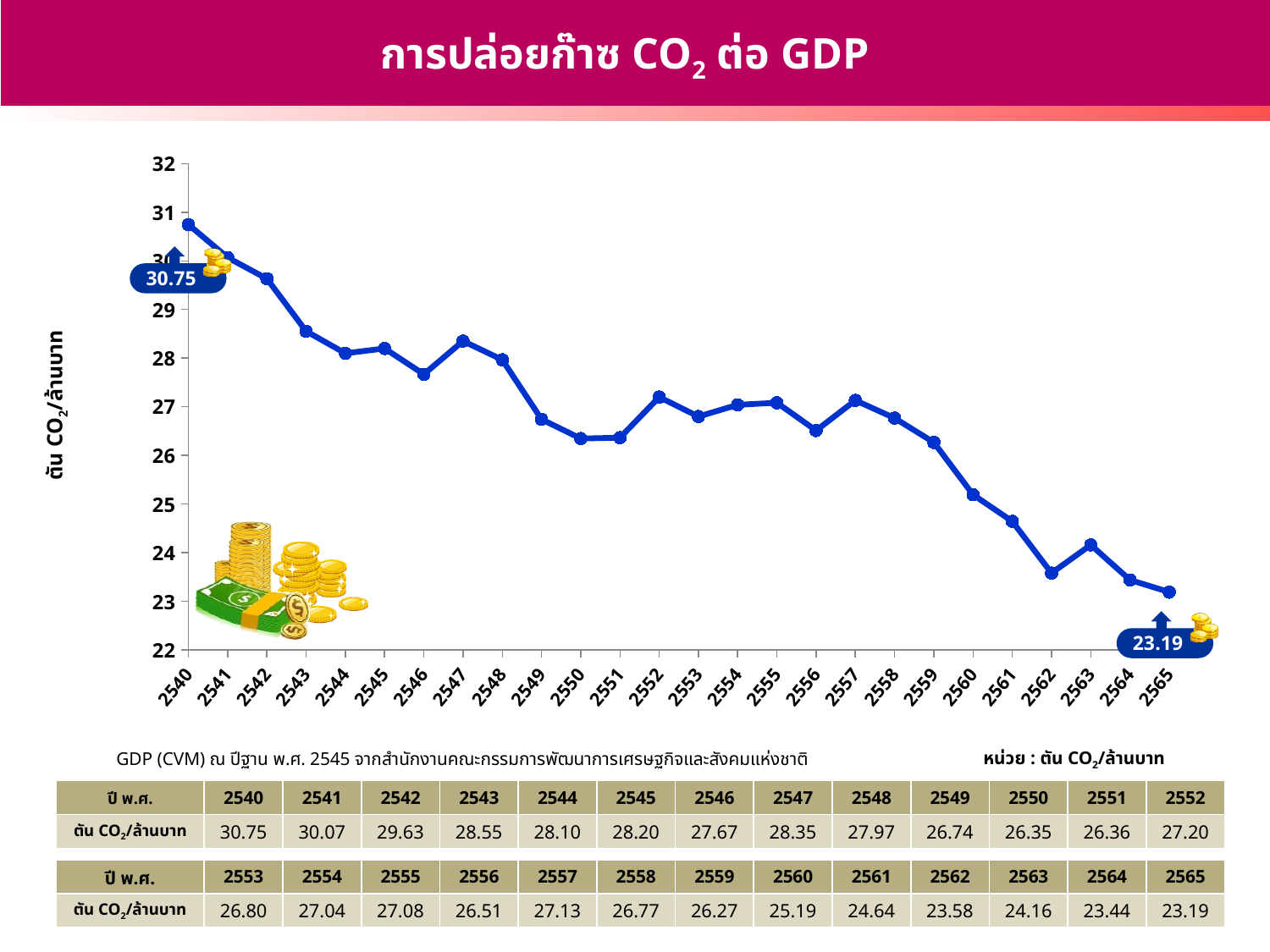
What is the value for the year 2560 according to the table? 25.19 Which year has the highest CO2 emission per GDP value? 2540 Which year has a larger value, 2547 or 2548? 2547 Which year has the lowest CO2 emission per GDP value? 2565 What is the CO2 emission per GDP value for the year 2565? 23.19 What is the difference between the values for 2540 and 2565? 7.56 What is the CO2 emission per GDP value for the year 2540? 30.75 Is the value for 2561 greater or less than 25? less How many years are plotted on the x axis? 26 What type of chart is shown on the slide? line chart What is the value for the year 2550 according to the table? 26.35 Does the CO2 emission per GDP generally rise or fall from 2540 to 2565? fall